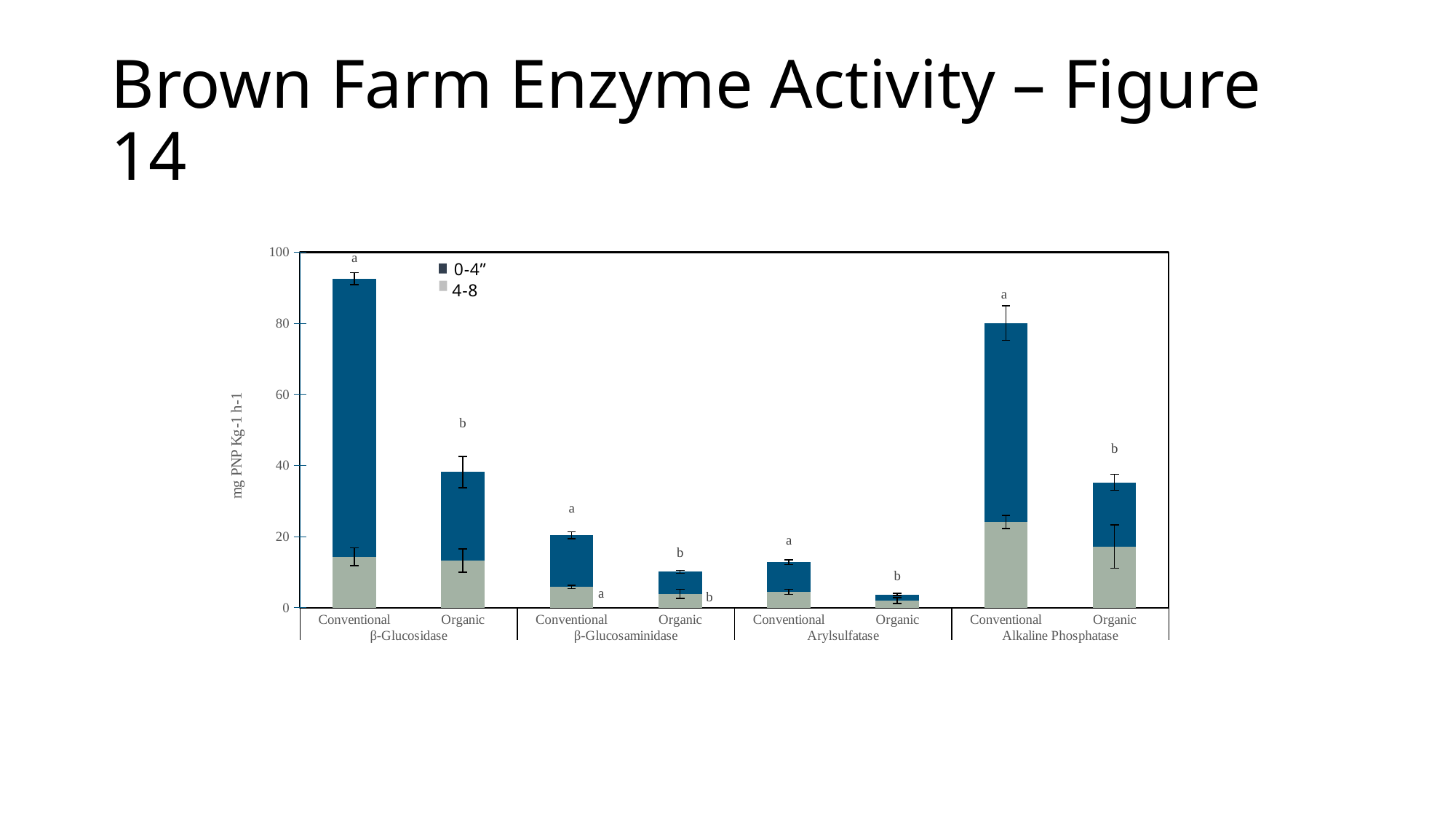
How many enzyme groups are shown along the x axis? 4 How many series does the legend list? 2 What are the two series named in the legend? 0-4" and 4-8 What kind of chart is shown on the slide? Stacked bar chart Is the total value for β-Glucosaminidase Conventional greater or less than 40? less Is the total value for Alkaline Phosphatase Conventional greater or less than 60? greater Which bar has the highest total value? β-Glucosidase Conventional What is the label on the vertical axis? mg PNP Kg-1 h-1 Which has the larger total value, β-Glucosidase Conventional or Alkaline Phosphatase Conventional? β-Glucosidase Conventional Which bar has the lowest total value? Arylsulfatase Organic How many stacked bars are plotted in total? 8 Is the total value for β-Glucosidase Conventional greater or less than 80? greater